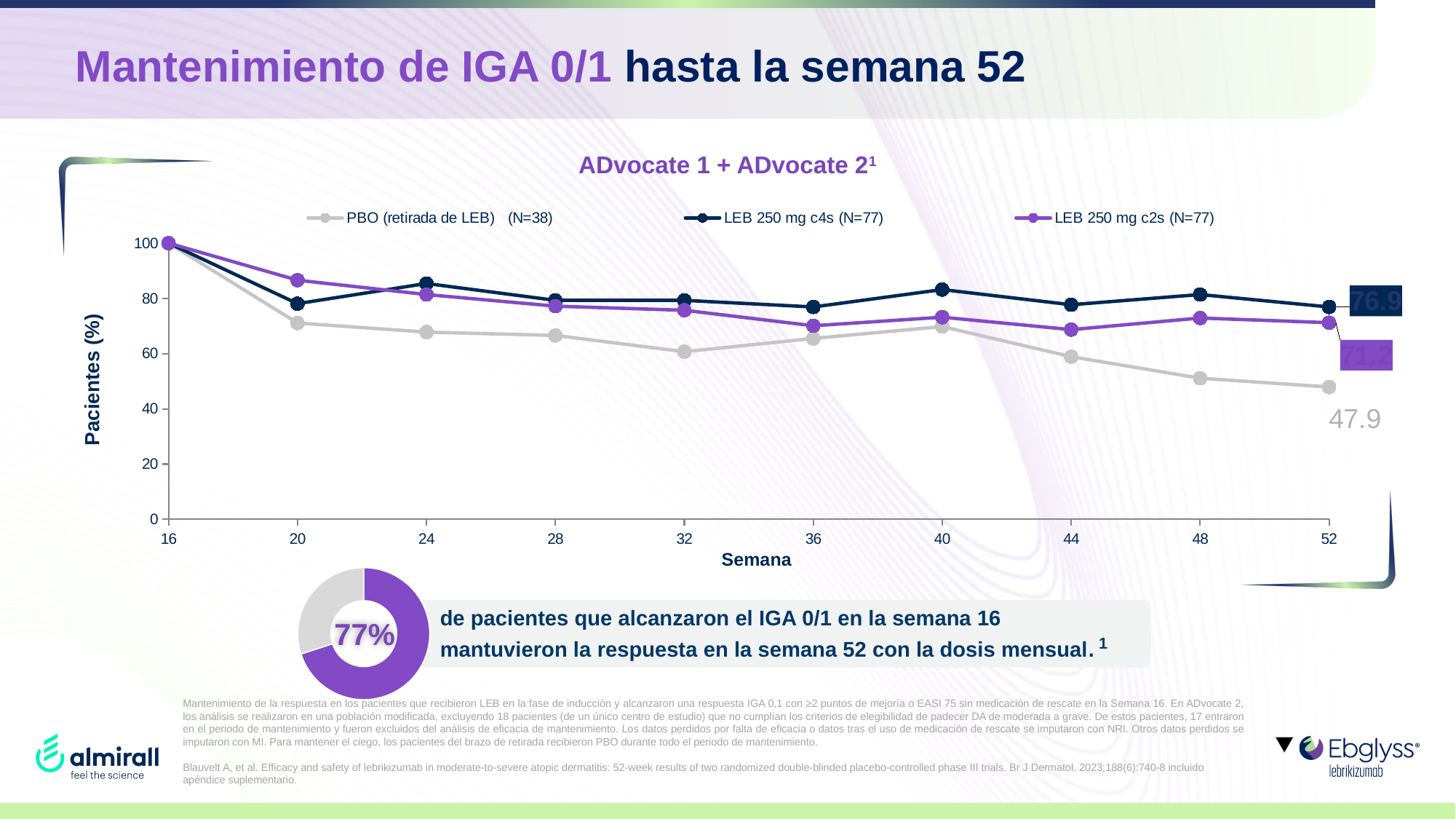
What percentage is shown in the donut chart below the line chart? 77% In the line chart, which series has the lowest value at week 52? PBO (retirada de LEB) (N=38) In the line chart, does the PBO (retirada de LEB) series rise or fall from week 16 to week 52? Fall How many series does the legend of the line chart list? 3 In the line chart, which series has the highest value at week 52? LEB 250 mg c4s (N=77) In the line chart, what is the value for LEB 250 mg c4s (N=77) at week 52? 76.9 What type of chart is used to show patients (%) by week? Line chart How many week points are plotted on the x axis of the line chart? 10 In the line chart, what is the value for PBO (retirada de LEB) (N=38) at week 52? 47.9 In the line chart, at week 20, which series is higher: LEB 250 mg c2s or LEB 250 mg c4s? LEB 250 mg c2s (N=77) In the line chart, is the value for PBO (retirada de LEB) at week 48 greater or less than 60? less In the line chart, what is the difference between the LEB 250 mg c4s value and the PBO value at week 52? 29.0